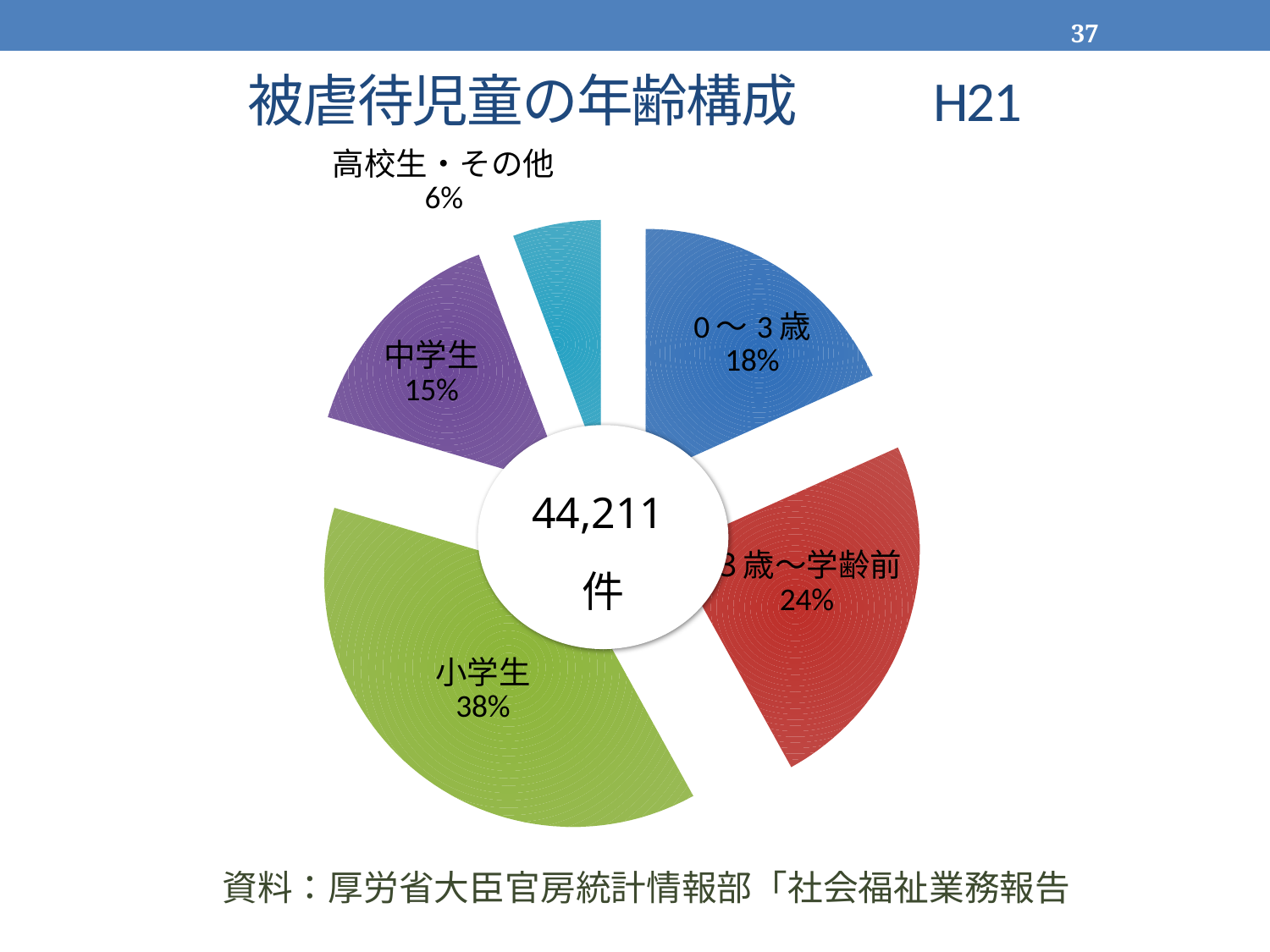
What total number of cases is shown in the centre of the pie chart? 44,211件 What percentage share does 3歳～学齢前 have in the pie chart? 24% How many categories are shown in the pie chart? 5 Which category has the largest share of the pie chart? 小学生 What kind of chart is shown on the slide? Pie chart What percentage share does 高校生・その他 have in the pie chart? 6% What percentage share does 0～3歳 have in the pie chart? 18% Which has a larger share, 0～3歳 or 中学生? 0～3歳 What is the difference in percentage points between 小学生 and 3歳～学齢前? 14 What percentage share does 小学生 have in the pie chart? 38% Which category has the smallest share of the pie chart? 高校生・その他 What percentage share does 中学生 have in the pie chart? 15%